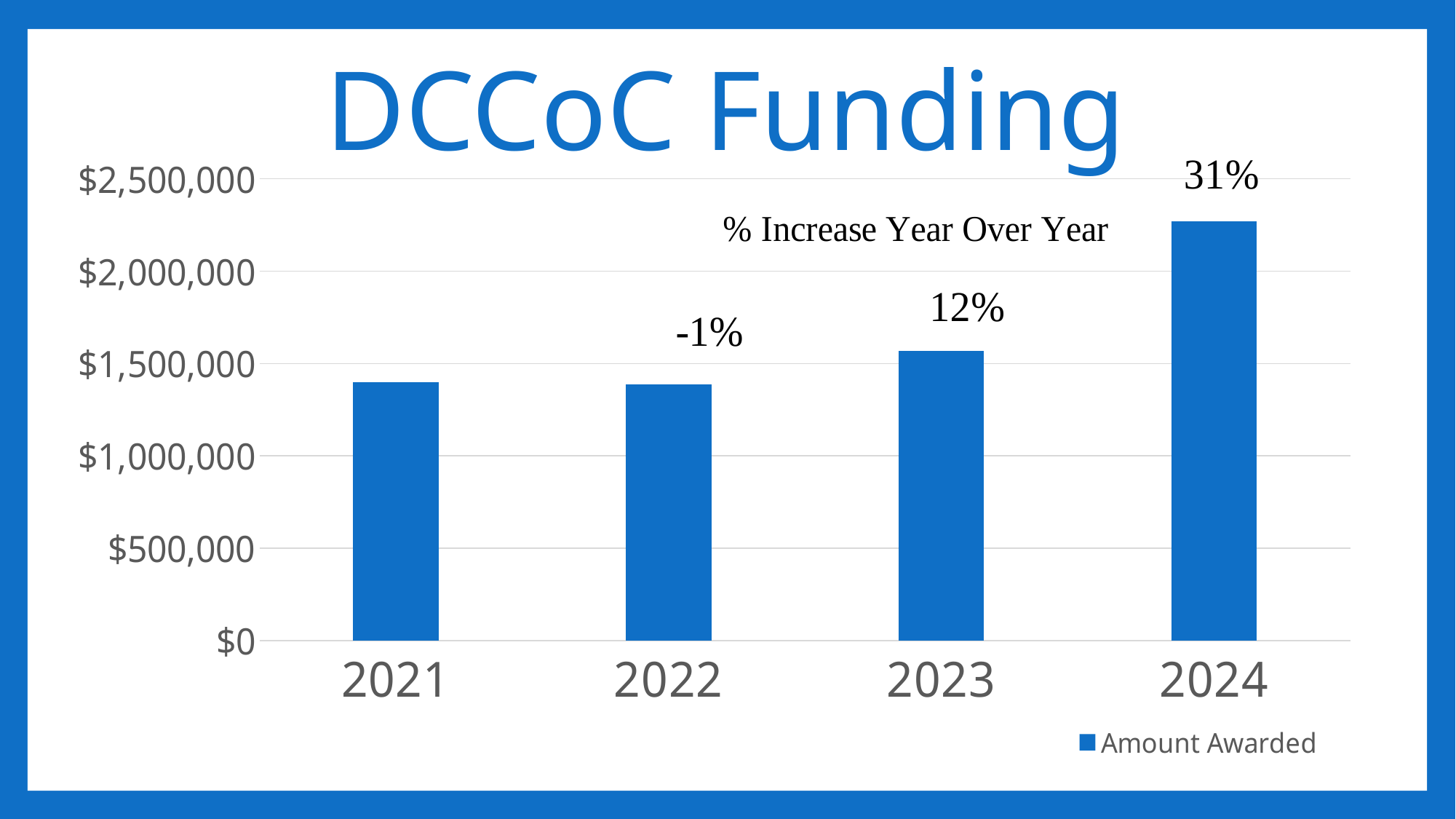
What is the % increase year over year shown for 2022? -1% What is the title of the chart? DCCoC Funding Which year has the larger amount awarded, 2023 or 2022? 2023 Which year has the highest amount awarded? 2024 What is the % increase year over year shown for 2024? 31% What kind of chart is shown on the slide? bar chart How many series does the legend list? 1 What is the name of the series shown in the legend? Amount Awarded Is the amount awarded for 2021 greater or less than $1,500,000? less How many years are shown on the x axis of the chart? 4 Is the amount awarded for 2024 greater or less than $2,000,000? greater What is the % increase year over year shown for 2023? 12%